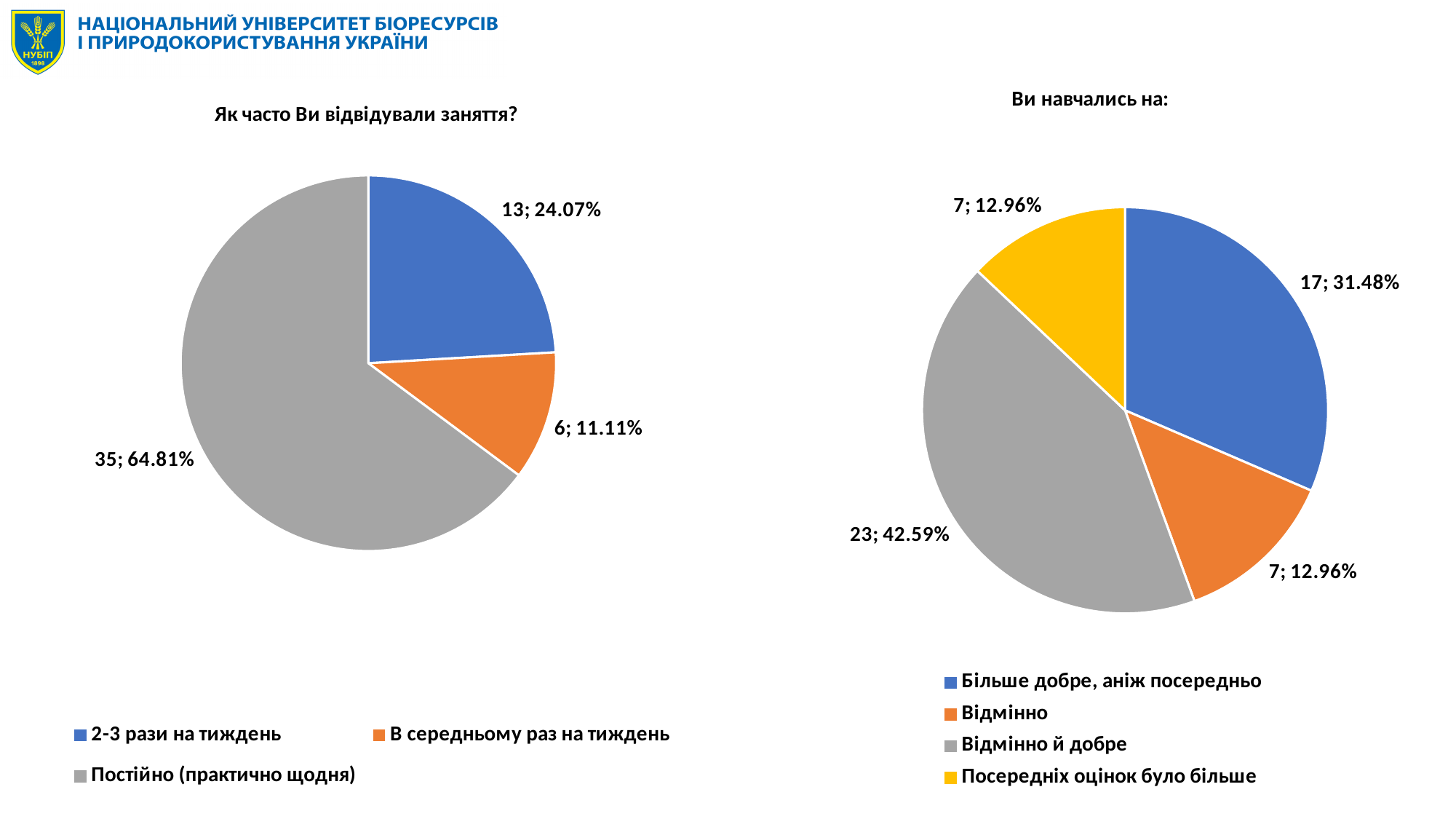
In the chart titled "Як часто Ви відвідували заняття?", how many respondents chose "Постійно (практично щодня)"? 35 What type of chart is used for "Ви навчались на:"? Pie chart In the chart titled "Ви навчались на:", how many categories does the legend list? 4 In the chart titled "Ви навчались на:", which category has the largest slice? Відмінно й добре In the chart titled "Як часто Ви відвідували заняття?", what share of the pie is "В середньому раз на тиждень"? 11.11% In the chart titled "Ви навчались на:", what share of the pie is "Більше добре, аніж посередньо"? 31.48% In the chart titled "Як часто Ви відвідували заняття?", which category has the largest slice? Постійно (практично щодня) In the chart titled "Як часто Ви відвідували заняття?", what is the difference in count between "Постійно (практично щодня)" and "2-3 рази на тиждень"? 22 In the chart titled "Як часто Ви відвідували заняття?", which category has the smallest slice? В середньому раз на тиждень In the chart titled "Ви навчались на:", which is larger: "Більше добре, аніж посередньо" or "Відмінно"? Більше добре, аніж посередньо In the chart titled "Як часто Ви відвідували заняття?", how many categories does the legend list? 3 In the chart titled "Ви навчались на:", how many respondents chose "Відмінно й добре"? 23